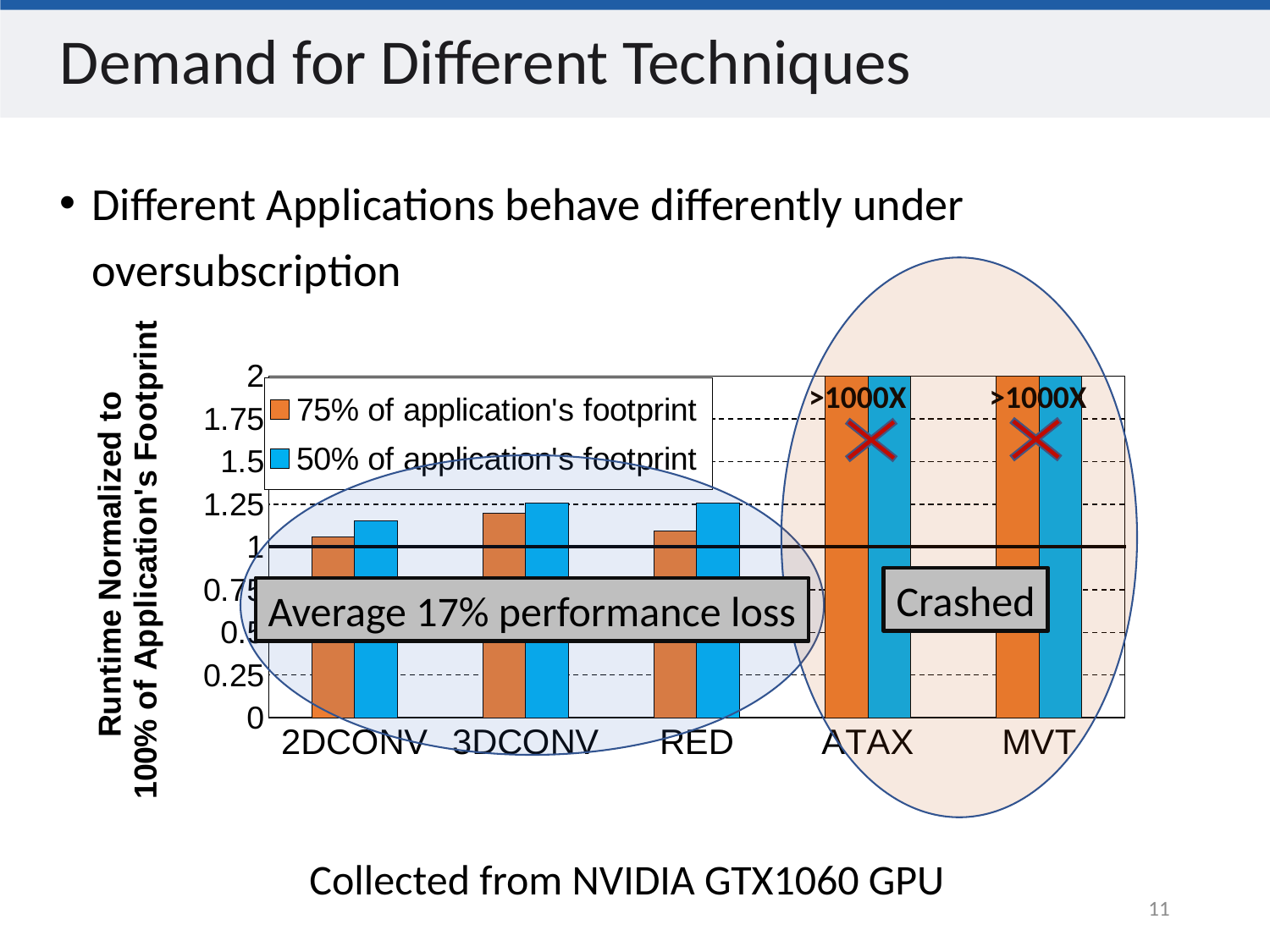
Is the value for RED in the 75% of application's footprint series greater or less than 1.25? less What kind of chart is shown on the slide? bar chart What annotation is printed above the ATAX and MVT bars in the chart? >1000X Among 2DCONV, 3DCONV and RED, which category has the highest value in the 75% of application's footprint series? 3DCONV For RED, which series has the larger value: 75% of application's footprint or 50% of application's footprint? 50% of application's footprint How many series does the chart's legend list? 2 What are the two series named in the chart's legend? 75% of application's footprint; 50% of application's footprint How many application categories are shown on the x axis of the chart? 5 Is the value for 2DCONV in the 75% of application's footprint series greater or less than 1.25? less Is the value for 3DCONV in the 50% of application's footprint series greater or less than 1? greater For 2DCONV, which series has the larger value: 75% of application's footprint or 50% of application's footprint? 50% of application's footprint